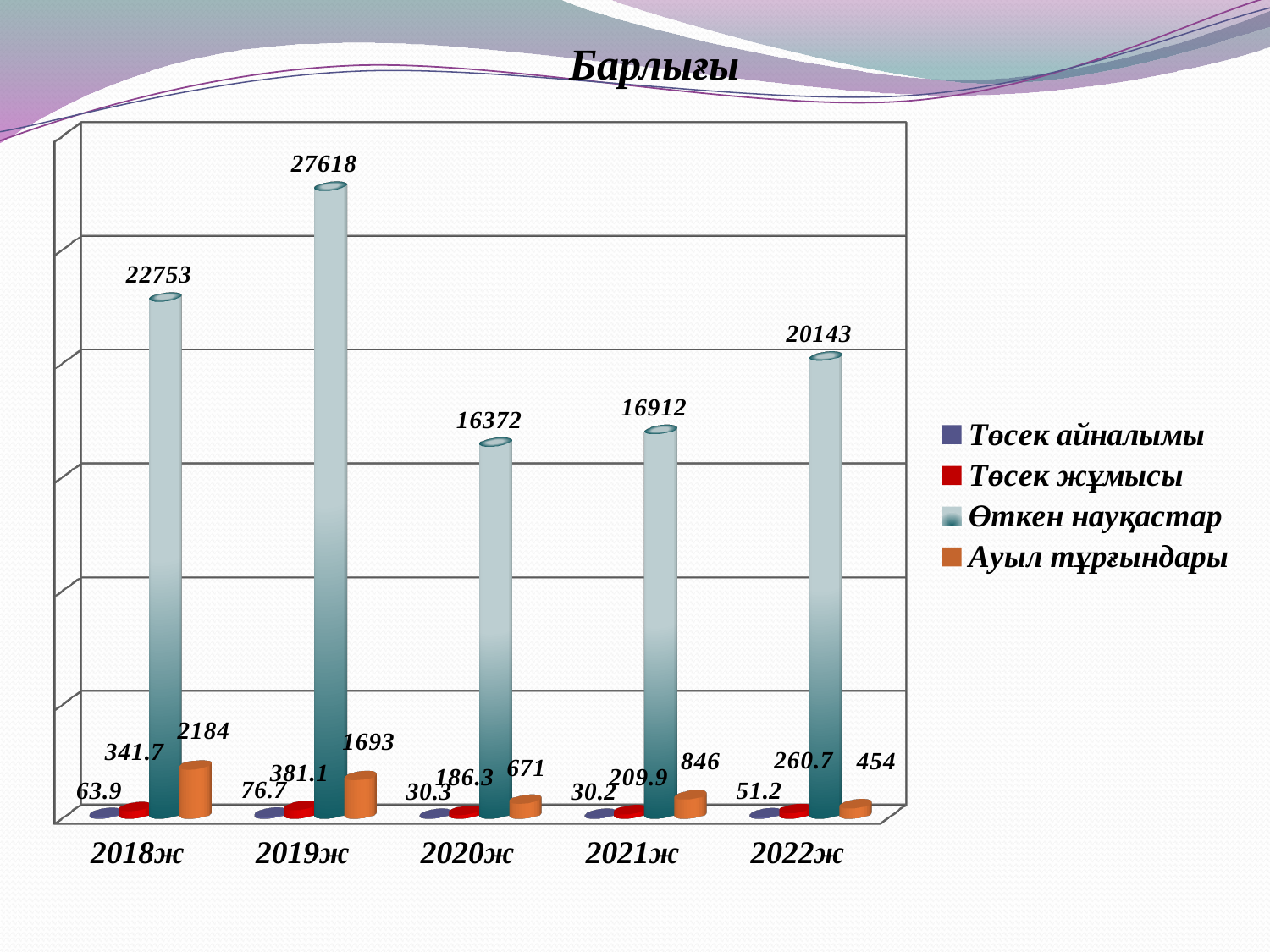
What is the value of Өткен науқастар for 2019ж? 27618 What is the value of Төсек жұмысы for 2022ж? 260.7 Which is larger: Ауыл тұрғындары in 2021ж or in 2020ж? 2021ж How many years are shown on the x axis? 5 What is the difference between Өткен науқастар in 2019ж and 2018ж? 4865 What is the value of Ауыл тұрғындары for 2018ж? 2184 In which year is Ауыл тұрғындары lowest? 2022ж In which year is Өткен науқастар highest? 2019ж How many series does the legend list? 4 What kind of chart is shown on the slide? Bar chart What is the title of the chart? Барлығы What is the value of Төсек айналымы for 2020ж? 30.3